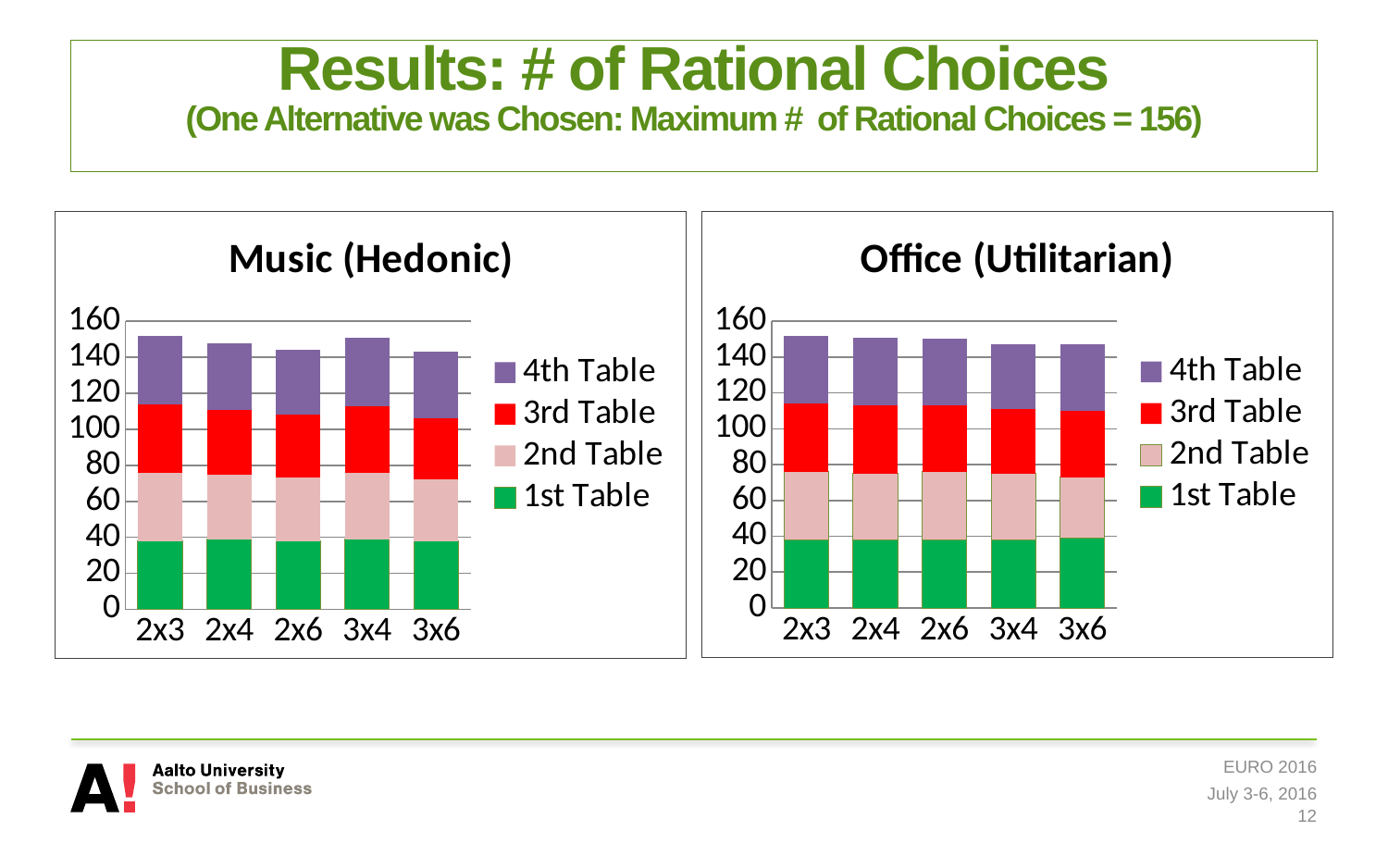
What is the highest value shown on the y axis of the Office (Utilitarian) chart? 160 In the Office (Utilitarian) chart, is the total stacked value for 2x6 greater or less than 120? greater In the Music (Hedonic) chart, which has the larger total stacked value, 2x3 or 3x6? 2x3 What is the title of the chart on the right side of the slide? Office (Utilitarian) In the Music (Hedonic) chart, is the 1st Table value for 2x4 greater or less than 60? less What are the category labels on the x axis of the Music (Hedonic) chart? 2x3, 2x4, 2x6, 3x4, 3x6 In the Music (Hedonic) chart, is the total stacked value for 2x3 greater or less than 140? greater In the Music (Hedonic) chart, which series is shown in purple at the top of each stacked bar? 4th Table How many categories are shown on the x axis of the Office (Utilitarian) chart? 5 What kind of chart is the Music (Hedonic) chart? stacked bar chart How many series does the legend of the Music (Hedonic) chart list? 4